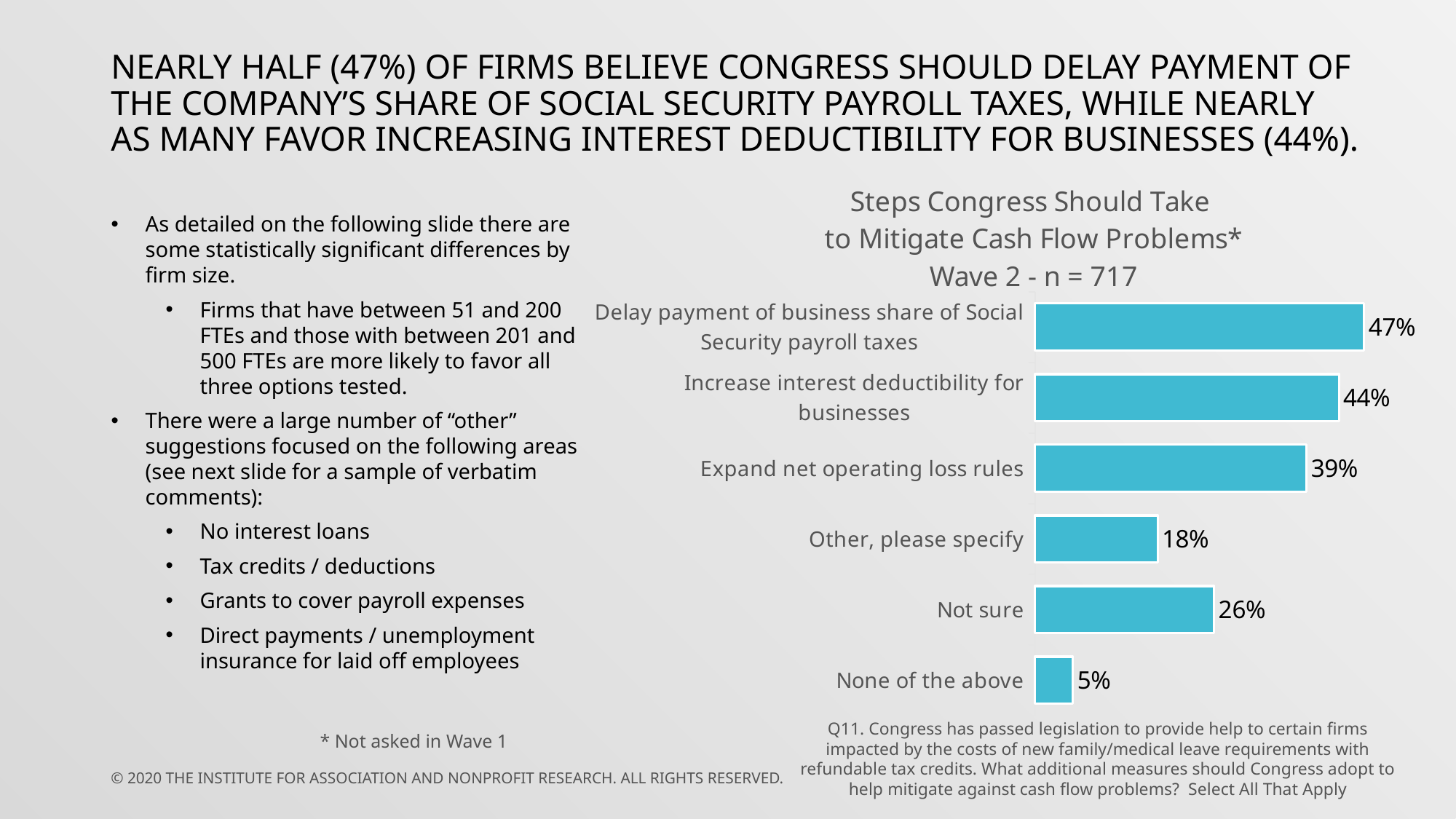
What percentage of firms answered "Not sure"? 26% What is the difference between the top two categories, "Delay payment of business share of Social Security payroll taxes" and "Increase interest deductibility for businesses"? 3 percentage points Which category has the highest value in the chart? Delay payment of business share of Social Security payroll taxes Which category has the lowest value in the chart? None of the above What is the difference between "Increase interest deductibility for businesses" and "Other, please specify"? 26 percentage points What type of chart is shown on the slide? Bar chart What percentage of firms selected "Delay payment of business share of Social Security payroll taxes"? 47% What is the value for "None of the above"? 5% What is the sample size (n) stated in the chart title? 717 How many categories are shown in the chart? 6 What is the value for "Expand net operating loss rules"? 39% Which is larger: "Not sure" or "Other, please specify"? Not sure